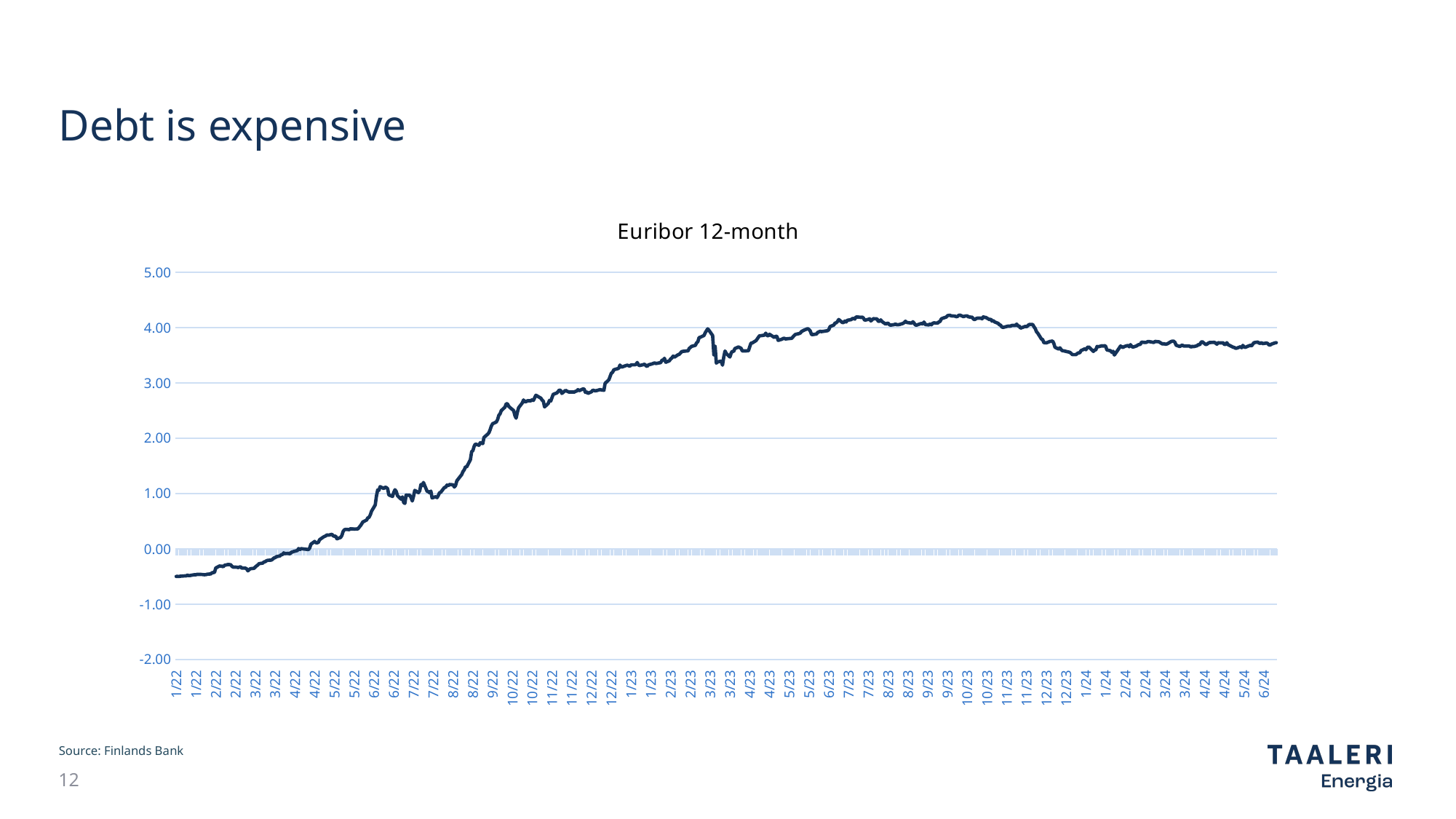
Is the value at 1/22 greater or less than 0.00? less Is the value at 1/24 greater or less than 4.00? less How many lines are plotted on the chart? 1 Is the value at 6/24 greater or less than 3.00? greater Does the Euribor 12-month line rise or fall between 10/23 and 1/24? fall What source is cited for the chart data? Finlands Bank Which is larger, the value at 1/22 or the value at 6/24? 6/24 What is the title of the chart? Euribor 12-month What kind of chart is shown on the slide? line chart Does the Euribor 12-month line overall rise or fall between 1/22 and 9/23? rise